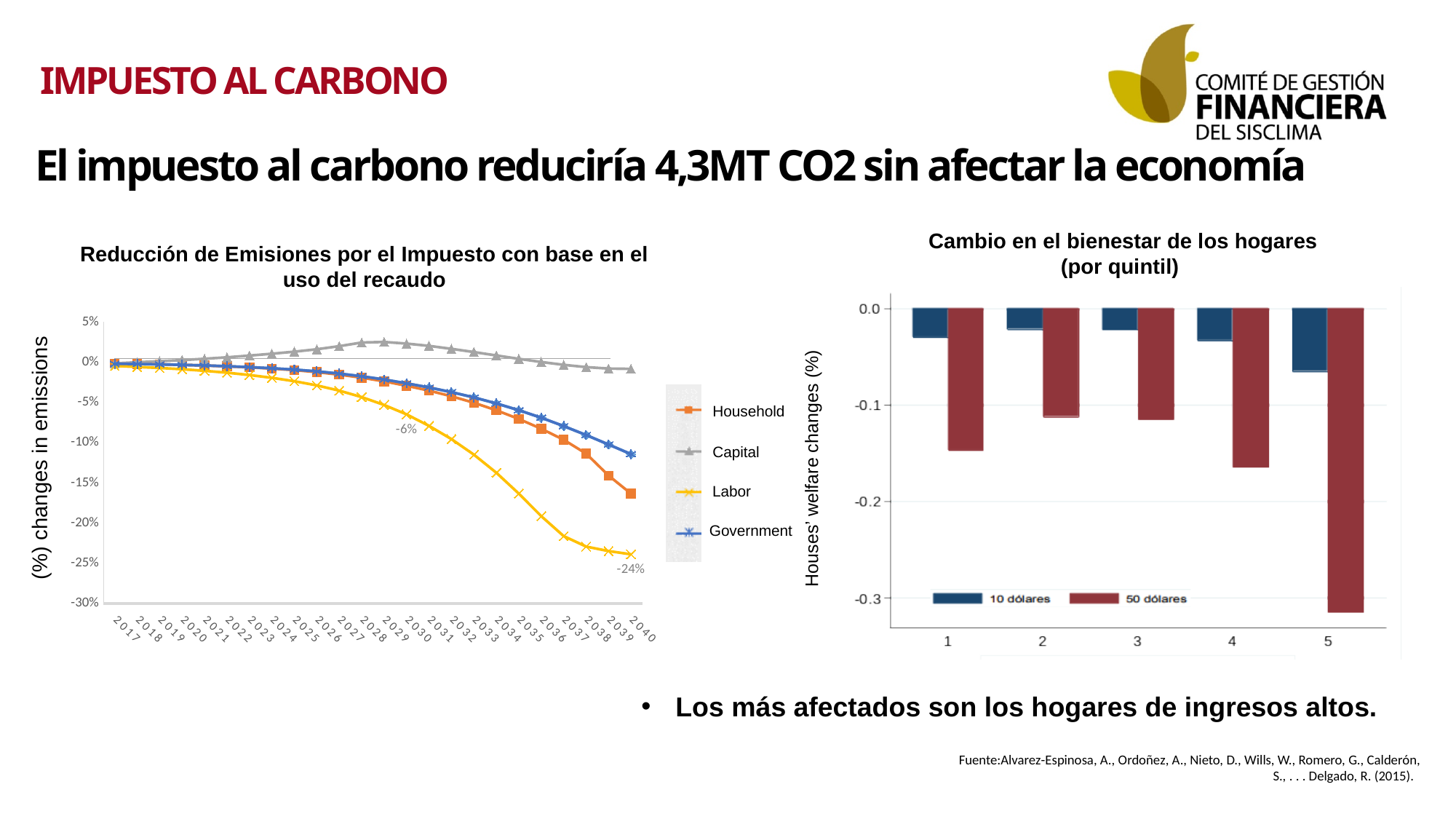
In the left chart, what is the labelled value of the Labor series in 2040? -24% In the left chart, which series has the highest value in 2040? Capital In the left chart, how many series does the legend list? 4 In the right chart, how many quintiles are shown on the x axis? 5 In the right chart, is the 50 dólares value for quintile 5 greater or less than -0.2? less In the right chart, for quintile 5, which series shows the larger welfare decrease, 10 dólares or 50 dólares? 50 dólares In the right chart, which quintile has the largest welfare decrease for the 50 dólares series? 5 In the left chart, which series has the lowest value in 2040? Labor In the right chart, how many series does the legend list? 2 What kind of chart is the left chart, 'Reducción de Emisiones por el Impuesto con base en el uso del recaudo'? Line chart What kind of chart is the right chart, 'Cambio en el bienestar de los hogares (por quintil)'? Bar chart In the left chart, does the Labor series rise or fall from 2017 to 2040? Fall